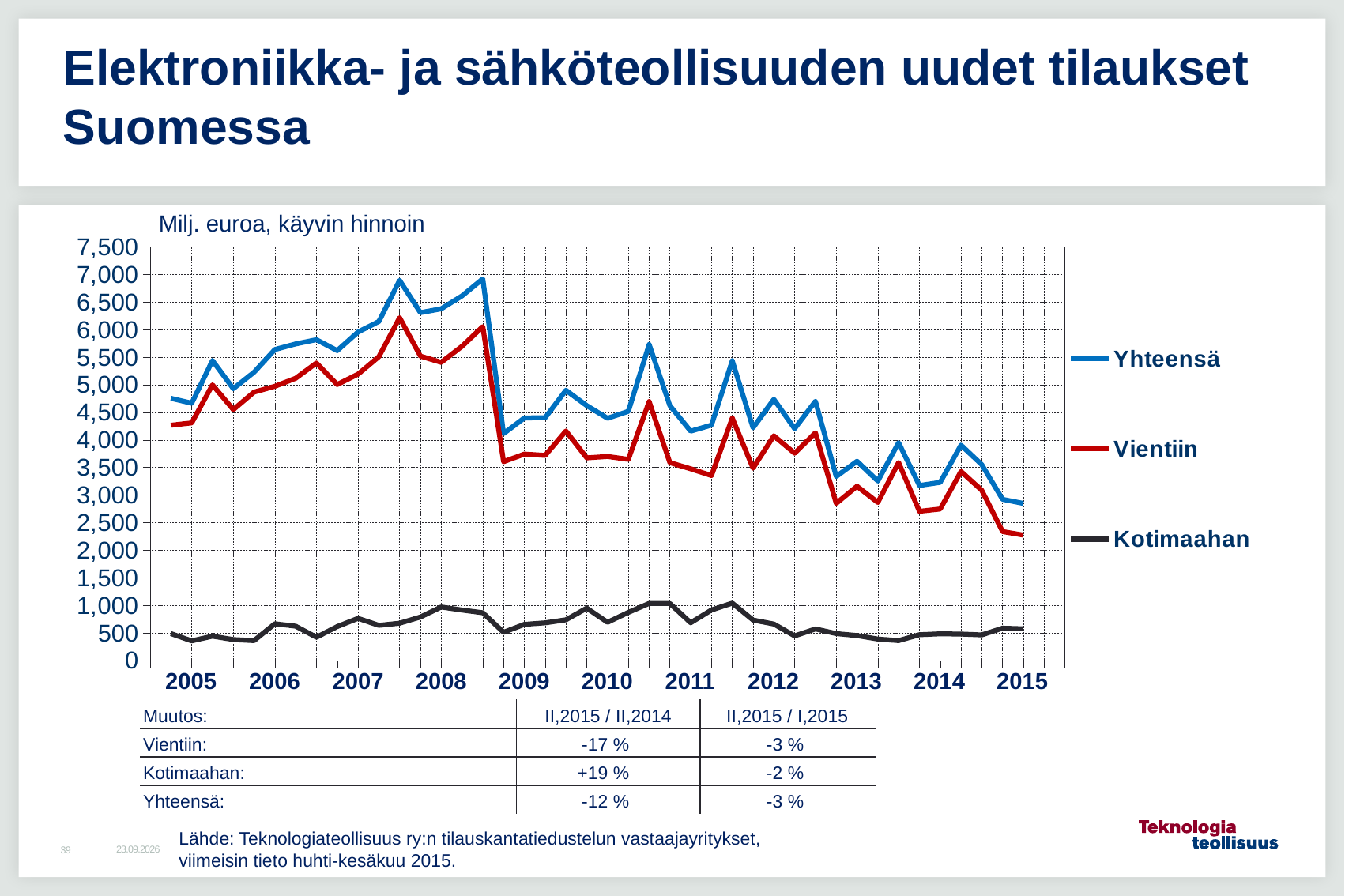
Which series has larger values, Vientiin or Kotimaahan? Vientiin Is the peak value of the Yhteensä series in 2008 greater or less than 6,500? greater Is the last plotted value of the Vientiin series in 2015 greater or less than 2,500? less What unit label is shown above the y axis of the chart? Milj. euroa, käyvin hinnoin Which series is plotted with the lowest values throughout the chart? Kotimaahan How many year labels are shown on the x axis? 11 What kind of chart is shown on the slide? line chart Is the last plotted value of the Yhteensä series in 2015 greater or less than 2,500? greater Which series is plotted with the highest values throughout the chart? Yhteensä Does the Yhteensä series overall rise or fall from 2009 to 2015? fall How many series does the chart legend list? 3